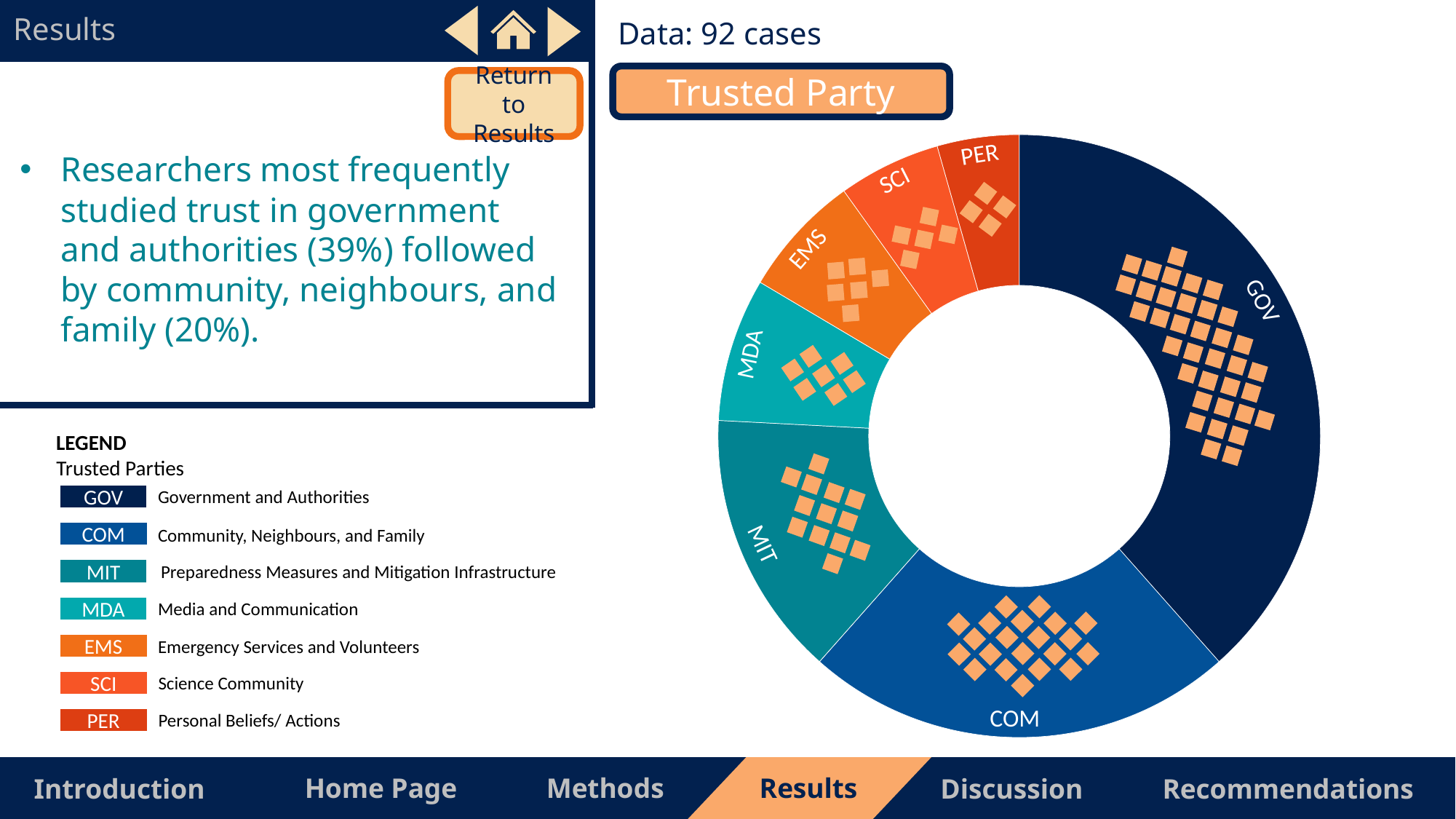
Which segment is larger, EMS or SCI? EMS Which trusted party has the smallest segment in the chart? PER According to the slide, what share of cases studied trust in government and authorities (GOV)? 39% What is the title of the chart? Trusted Party Which trusted party has the largest segment in the chart? GOV According to the slide, what share of cases studied trust in community, neighbours, and family (COM)? 20% How many cases does the chart's data cover? 92 cases What kind of chart is shown on the slide? Pie (donut) chart Which segment is larger, GOV or COM? GOV How many categories (segments) does the Trusted Party chart have? 7 Which segment is larger, MIT or MDA? MIT